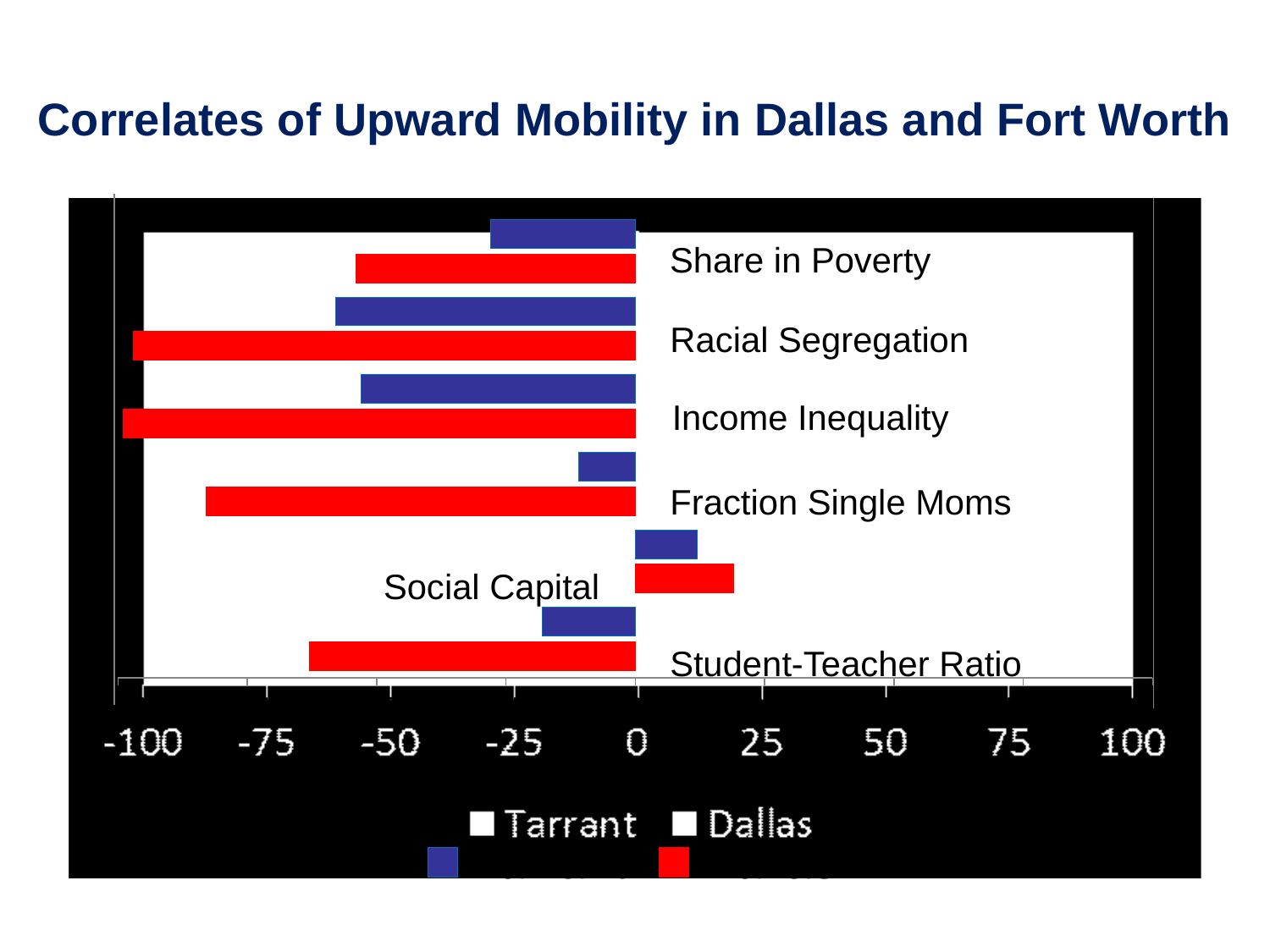
How many categories are plotted in the chart? 6 Is the Tarrant value for Share in Poverty greater or less than -50? greater Is the Tarrant value for Fraction Single Moms greater or less than -25? greater What kind of chart is shown on the slide? bar chart How many series does the legend list? 2 For Social Capital, which series has the larger value, Tarrant or Dallas? Dallas For Share in Poverty, which series has the higher value, Tarrant or Dallas? Tarrant Is the Dallas value for Student-Teacher Ratio greater or less than -50? less Which category has the highest Tarrant value? Social Capital Which category has the highest Dallas value? Social Capital What colour are the Dallas bars in the chart? red